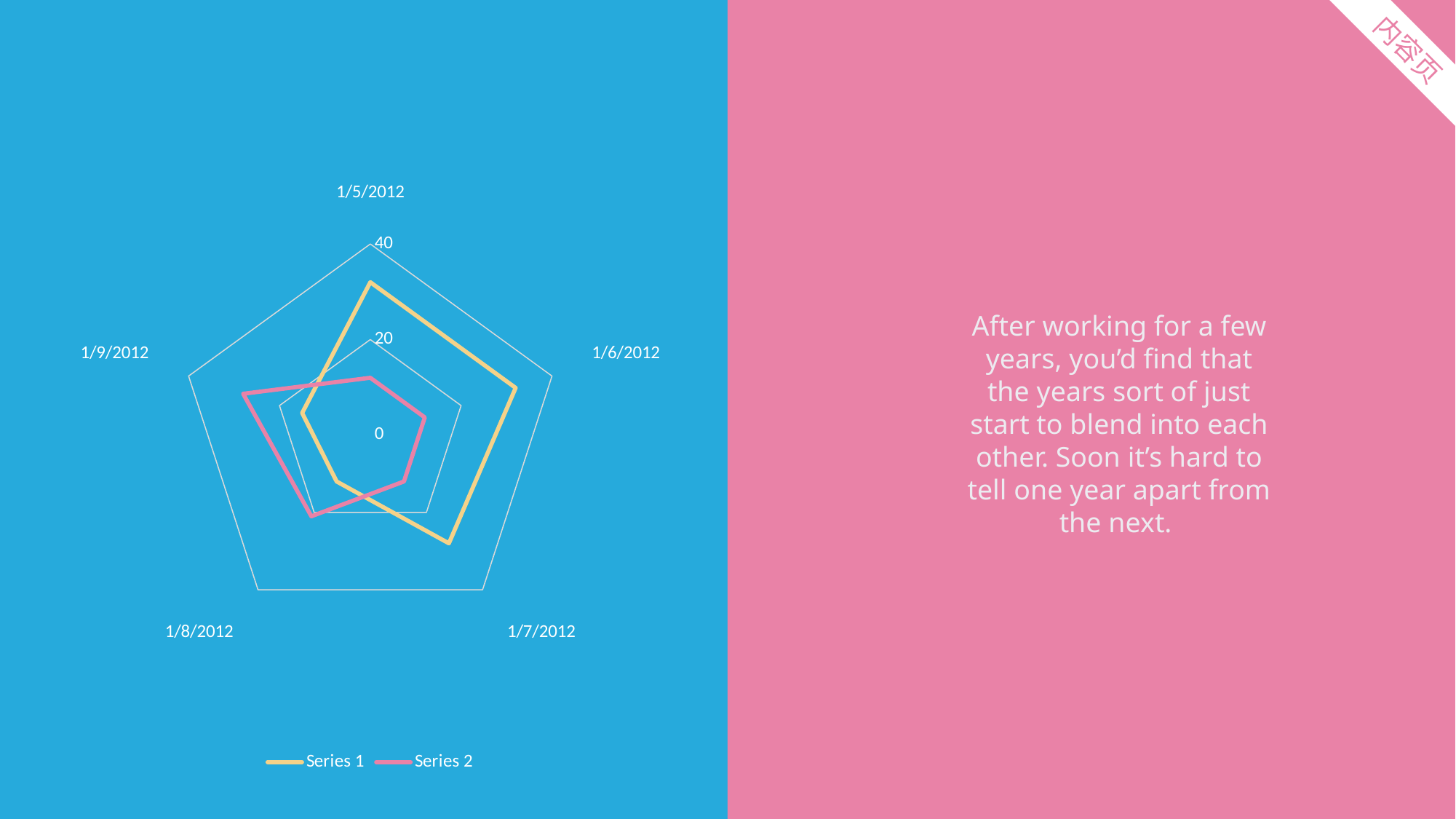
Is the value of Series 1 for 1/5/2012 greater or less than 20? greater For 1/5/2012, which series has the larger value, Series 1 or Series 2? Series 1 Is the value of Series 2 for 1/9/2012 greater or less than 20? greater Is the value of Series 1 for 1/8/2012 greater or less than 20? less For which date does Series 2 reach its highest value? 1/9/2012 What is the highest value shown on the chart's axis scale? 40 For 1/9/2012, which series has the larger value, Series 1 or Series 2? Series 2 What kind of chart is shown on the slide? Radar chart How many series does the legend list? 2 How many categories (dates) does the radar chart have? 5